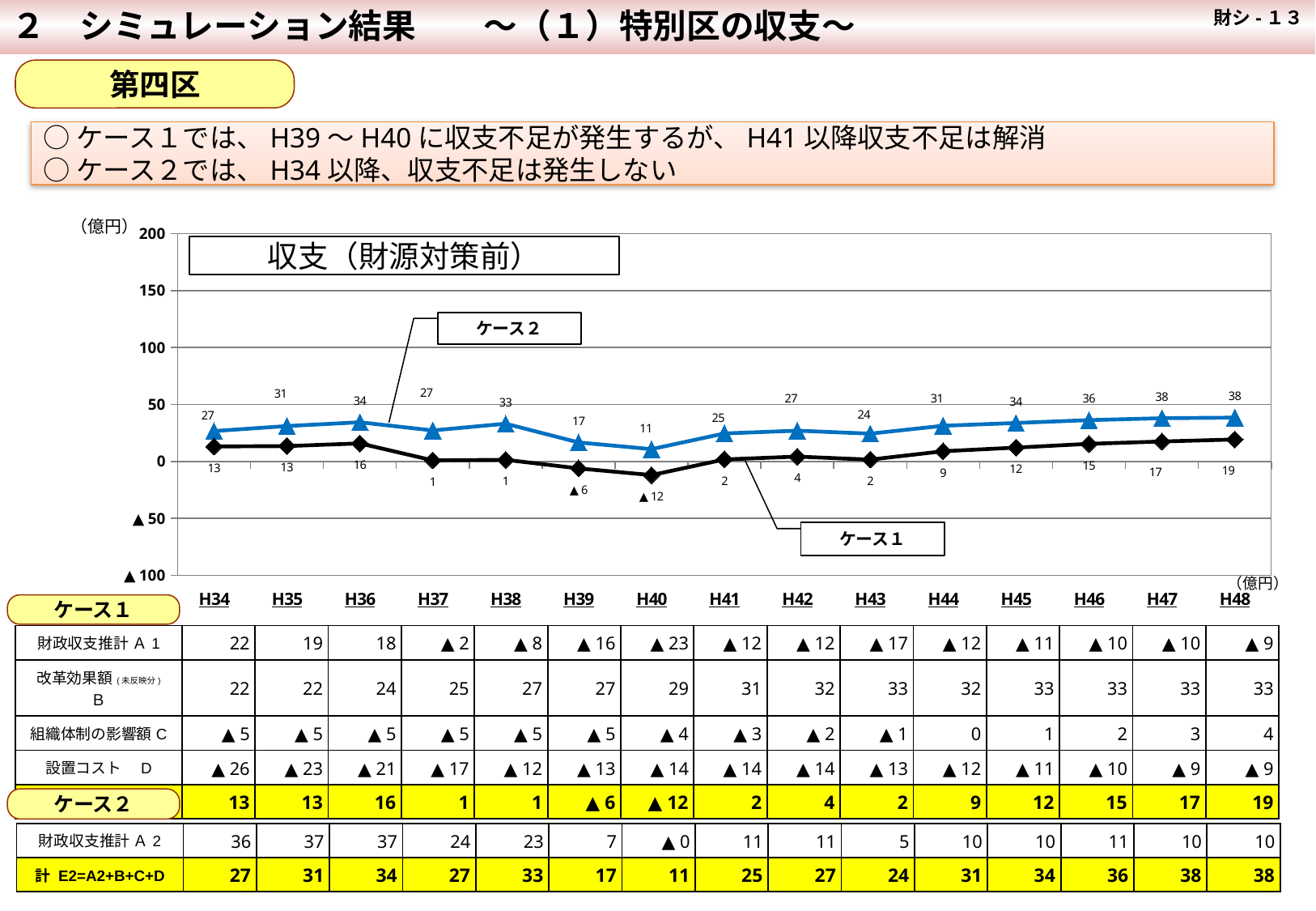
What type of chart is shown on the slide? line chart At which year does ケース2 reach its lowest value? H40 At which year does ケース1 reach its lowest value? H40 What is the value of ケース2 at H39? 17 Which series has the larger value at H37, ケース1 or ケース2? ケース2 What is the value of ケース1 at H40? ▲12 What is the value of ケース2 at H36? 34 What is the difference between ケース2 and ケース1 at H48? 19 What is the highest value of ケース1 on the chart? 19 Do the values of ケース1 rise or fall from H40 to H48? rise What is the title of the chart? 収支（財源対策前） How many data points (years) are plotted along the x axis of the chart? 15